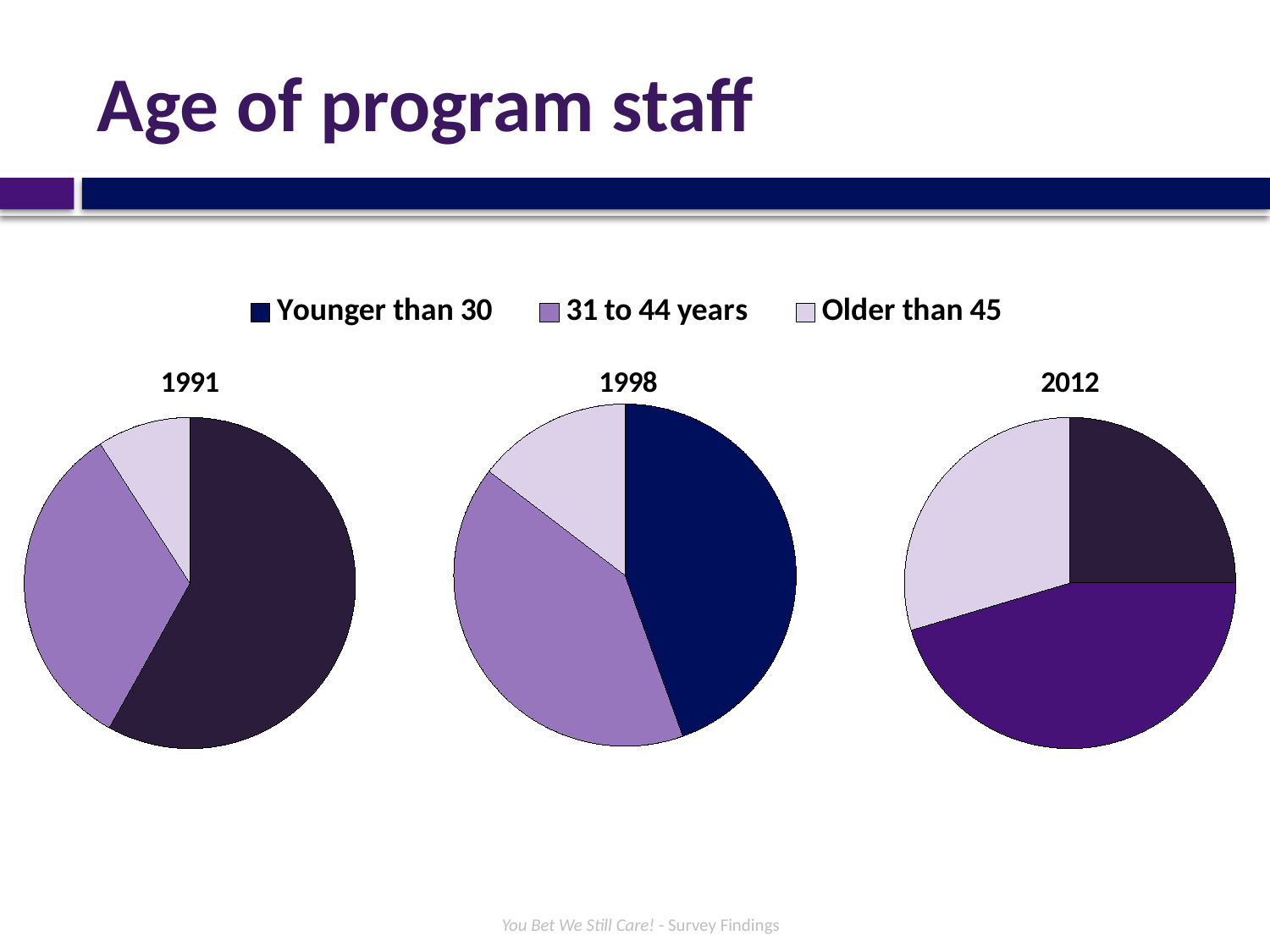
In the 1998 pie chart, which age group has the smallest slice? Older than 45 What kind of charts are shown on the slide? Pie charts In the 1998 pie chart, which slice is larger: 31 to 44 years or Older than 45? 31 to 44 years What is the title of the slide? Age of program staff How many categories does the legend list? 3 In the 2012 pie chart, which slice is larger: Younger than 30 or 31 to 44 years? 31 to 44 years In the 1991 pie chart, which age group has the largest slice? Younger than 30 How many pie charts are on the slide? 3 In the 2012 pie chart, which age group has the largest slice? 31 to 44 years How many slices does the 1991 pie chart have? 3 In the 1991 pie chart, which age group has the smallest slice? Older than 45 In the 1998 pie chart, which age group has the largest slice? Younger than 30